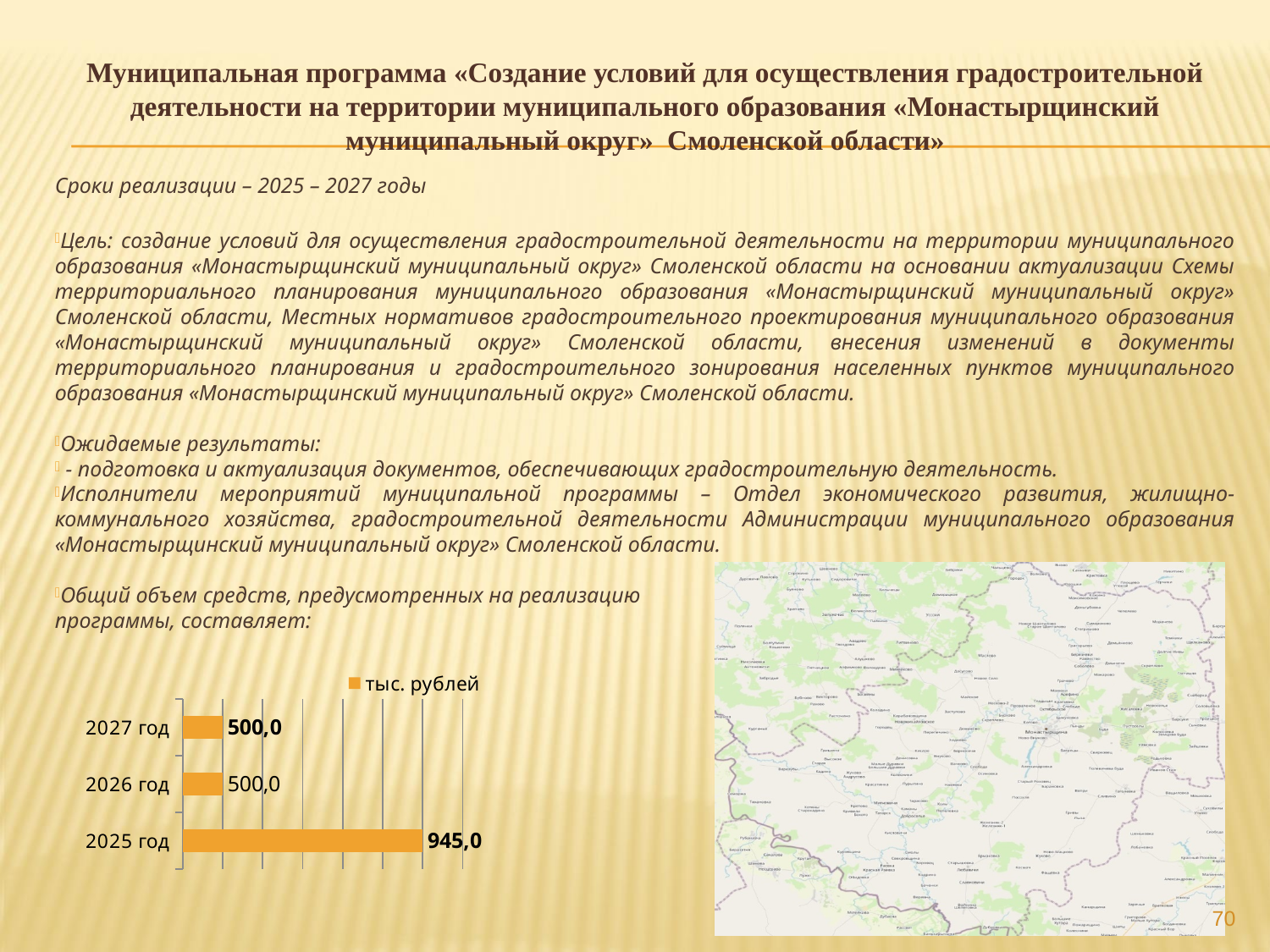
What is the value for 2026 год on the chart? 500,0 What is the difference between the values for 2025 год and 2026 год? 445,0 Which year has the highest value on the chart? 2025 год What is the value for 2025 год on the chart? 945,0 Are the values for 2026 год and 2027 год equal? yes What is the value for 2027 год on the chart? 500,0 Which is larger, the value for 2025 год or the value for 2027 год? 2025 год What kind of chart is shown on the slide? bar chart What is the legend entry of the chart? тыс. рублей What is the total of the values for 2025 год, 2026 год and 2027 год? 1945,0 How many categories (years) are shown on the chart? 3 How many series does the chart legend list? 1